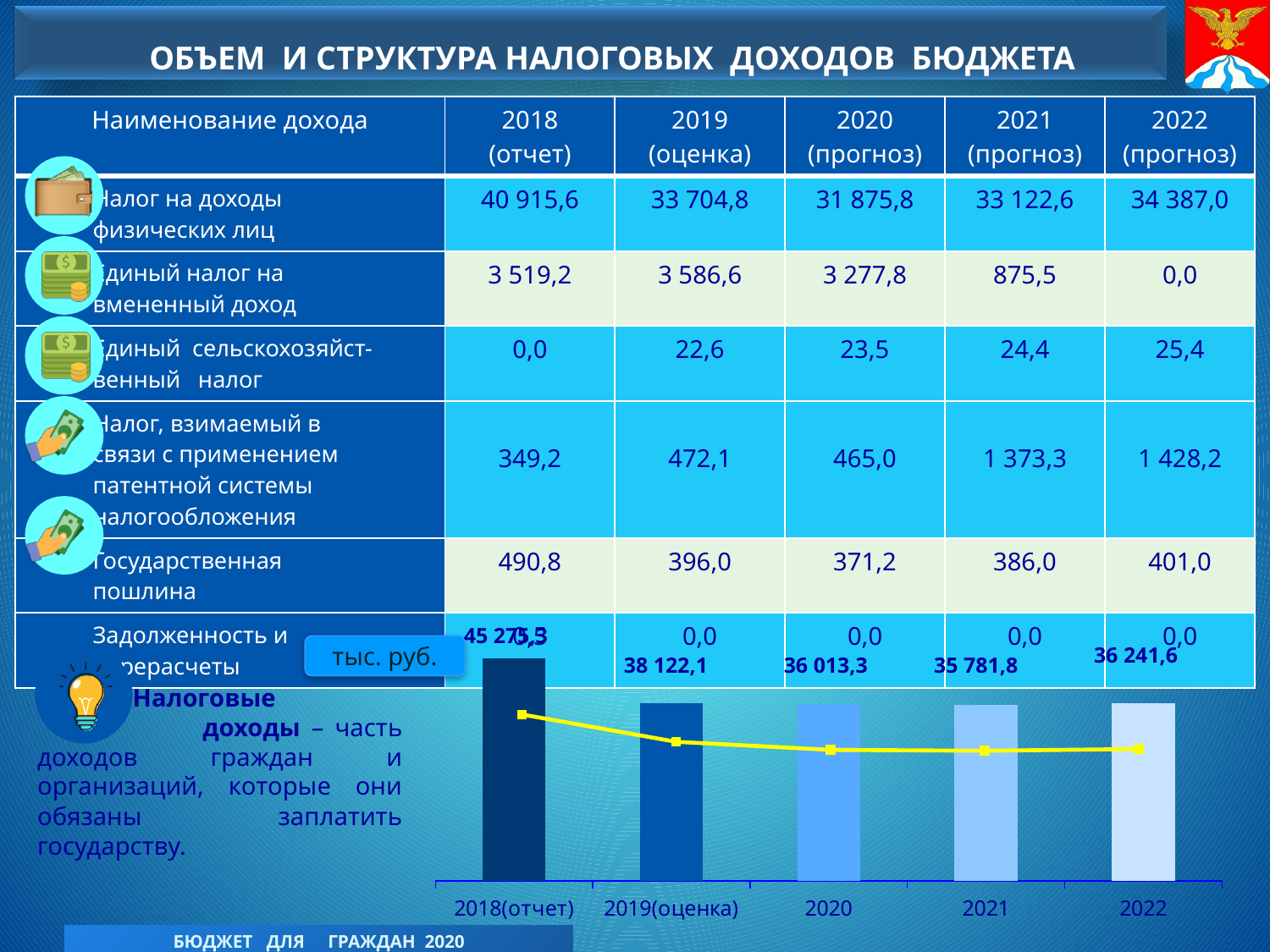
How many years are shown on the x axis of the bar chart at the bottom of the slide? 5 In the bar chart at the bottom of the slide, which is larger, the value for 2019(оценка) or the value for 2020? 2019(оценка) In the bar chart at the bottom of the slide, what is the value for 2020? 36 013,3 In the bar chart at the bottom of the slide, which year has the highest value? 2018(отчет) In the bar chart at the bottom of the slide, what is the difference between the values for 2020 and 2021? 231,5 In the bar chart at the bottom of the slide, what is the difference between the values for 2022 and 2021? 459,8 In the bar chart at the bottom of the slide, what is the value for 2019(оценка)? 38 122,1 What kind of chart is shown at the bottom of the slide? bar chart In the bar chart at the bottom of the slide, which year has the lowest value? 2021 In the bar chart at the bottom of the slide, what is the value for 2022? 36 241,6 In the bar chart at the bottom of the slide, what is the value for 2021? 35 781,8 In the bar chart at the bottom of the slide, do the values rise or fall from 2018(отчет) to 2021? fall